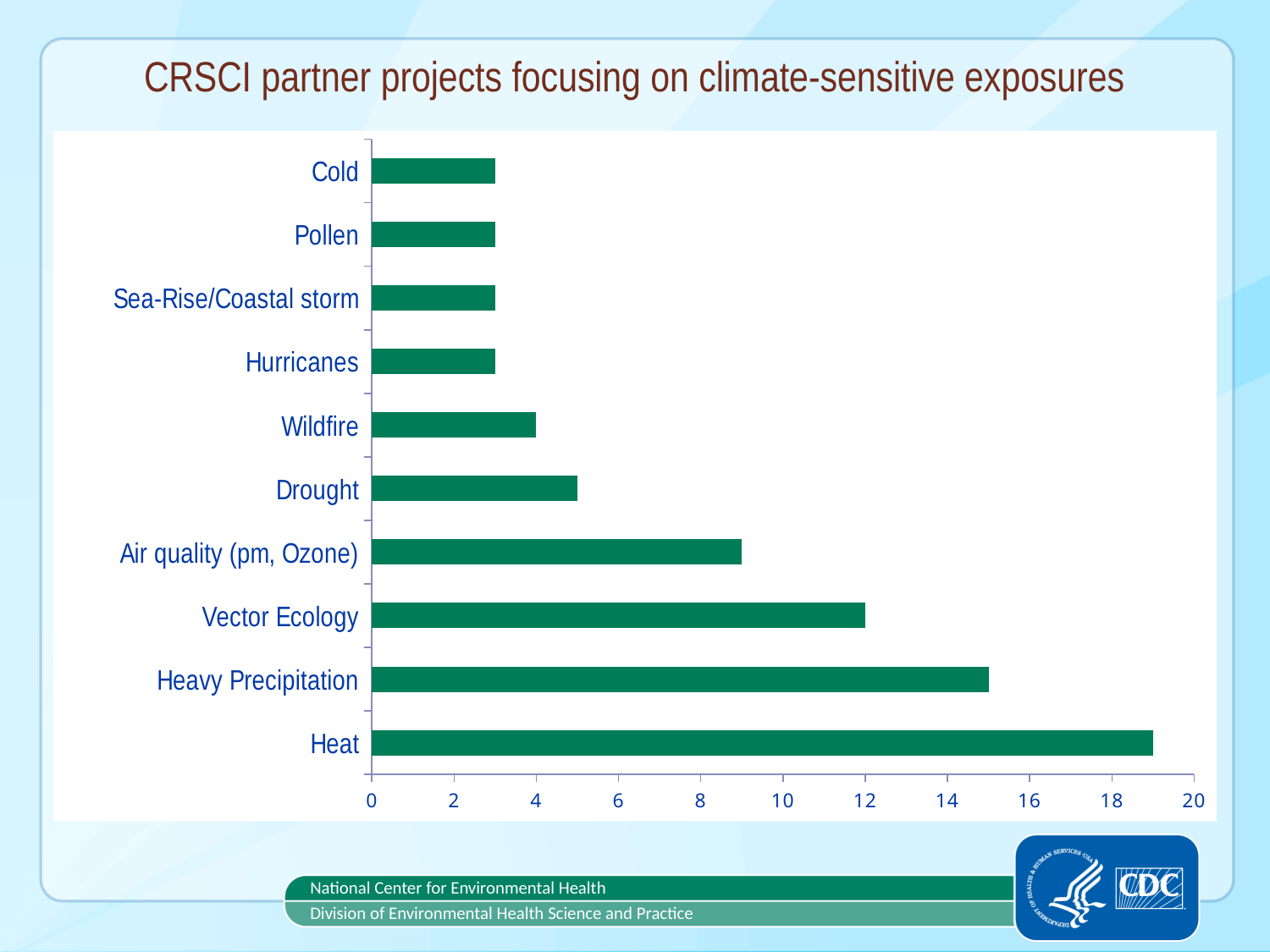
Is the value for Heat greater or less than 18? greater Which has a larger value, Air quality (pm, Ozone) or Drought? Air quality (pm, Ozone) What is the value for Wildfire? 4 What is the title of the chart? CRSCI partner projects focusing on climate-sensitive exposures Is the value for Heavy Precipitation greater or less than 14? greater How many exposure categories are plotted in the chart? 10 Is the value for Air quality (pm, Ozone) greater or less than 10? less What kind of chart is shown on the slide? bar chart What is the value for Vector Ecology? 12 Which has a larger value, Heavy Precipitation or Vector Ecology? Heavy Precipitation Which category has the highest value? Heat